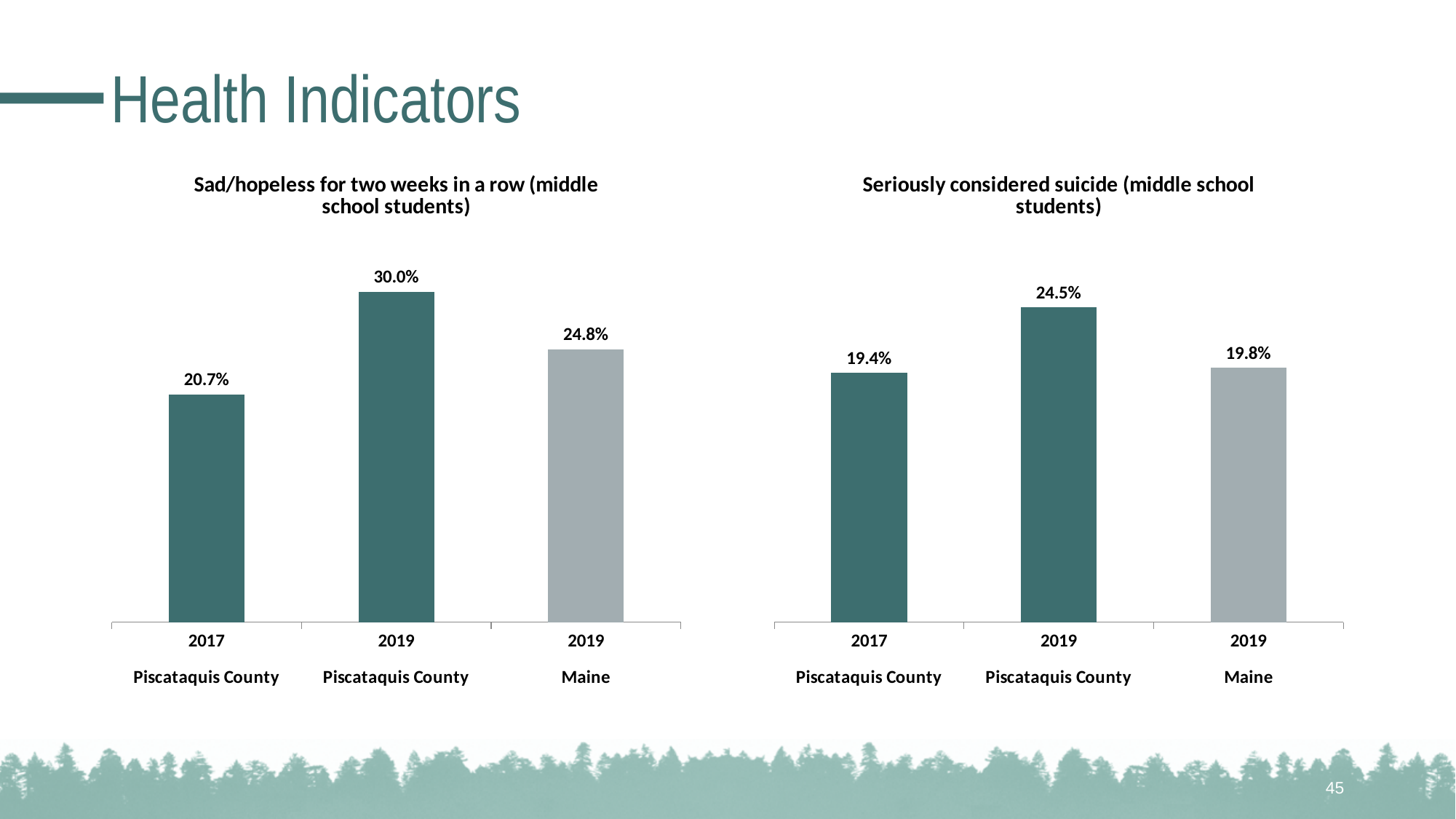
In the 'Sad/hopeless for two weeks in a row (middle school students)' chart, what is the value for Piscataquis County in 2019? 30.0% In the 'Sad/hopeless for two weeks in a row (middle school students)' chart, which bar has the highest value? Piscataquis County 2019 In the 'Sad/hopeless for two weeks in a row (middle school students)' chart, what is the value for Piscataquis County in 2017? 20.7% In the 'Sad/hopeless for two weeks in a row (middle school students)' chart, what is the difference between Piscataquis County 2019 and Piscataquis County 2017? 9.3% What kind of chart is the 'Seriously considered suicide (middle school students)' chart? Bar chart In the 'Seriously considered suicide (middle school students)' chart, what is the value for Maine in 2019? 19.8% How many bars are in the 'Sad/hopeless for two weeks in a row (middle school students)' chart? 3 In the 'Seriously considered suicide (middle school students)' chart, which bar has the lowest value? Piscataquis County 2017 In the 'Seriously considered suicide (middle school students)' chart, which is larger: Piscataquis County 2019 or Maine 2019? Piscataquis County 2019 In the 'Sad/hopeless for two weeks in a row (middle school students)' chart, what is the value for Maine in 2019? 24.8% In the 'Seriously considered suicide (middle school students)' chart, what is the value for Piscataquis County in 2019? 24.5% In the 'Seriously considered suicide (middle school students)' chart, what is the difference between Piscataquis County 2019 and Maine 2019? 4.7%